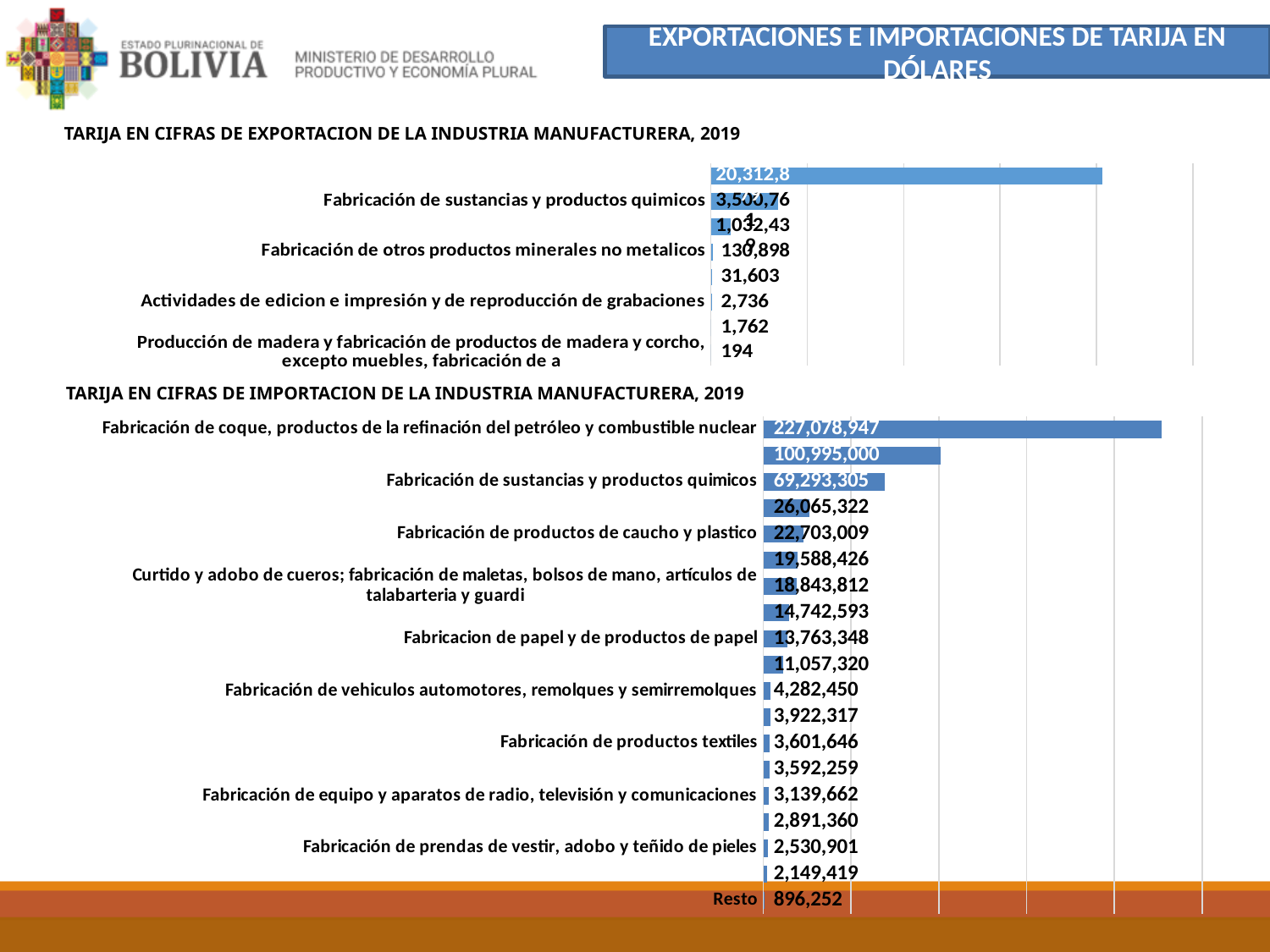
In the export chart, what is the value for Producción de madera y fabricación de productos de madera y corcho, excepto muebles, fabricación de a? 194 In the export chart (TARIJA EN CIFRAS DE EXPORTACION DE LA INDUSTRIA MANUFACTURERA, 2019), what is the value for Fabricación de otros productos minerales no metalicos? 130,898 In the import chart, which category has the lowest value? Resto In the import chart (TARIJA EN CIFRAS DE IMPORTACION DE LA INDUSTRIA MANUFACTURERA, 2019), what is the value for Fabricación de coque, productos de la refinación del petróleo y combustible nuclear? 227,078,947 In the import chart, what is the difference between Fabricación de sustancias y productos quimicos and Fabricación de productos de caucho y plastico? 46,590,296 In the import chart, what is the value for Resto? 896,252 In the import chart, what is the value for Fabricación de vehiculos automotores, remolques y semirremolques? 4,282,450 In the import chart, what is the value for Fabricación de productos de caucho y plastico? 22,703,009 In the import chart, which category has the highest value? Fabricación de coque, productos de la refinación del petróleo y combustible nuclear How many bars are plotted in the import chart? 19 In the import chart, which is larger: Fabricación de productos textiles or Fabricación de prendas de vestir, adobo y teñido de pieles? Fabricación de productos textiles What type of chart is the export chart? Bar chart